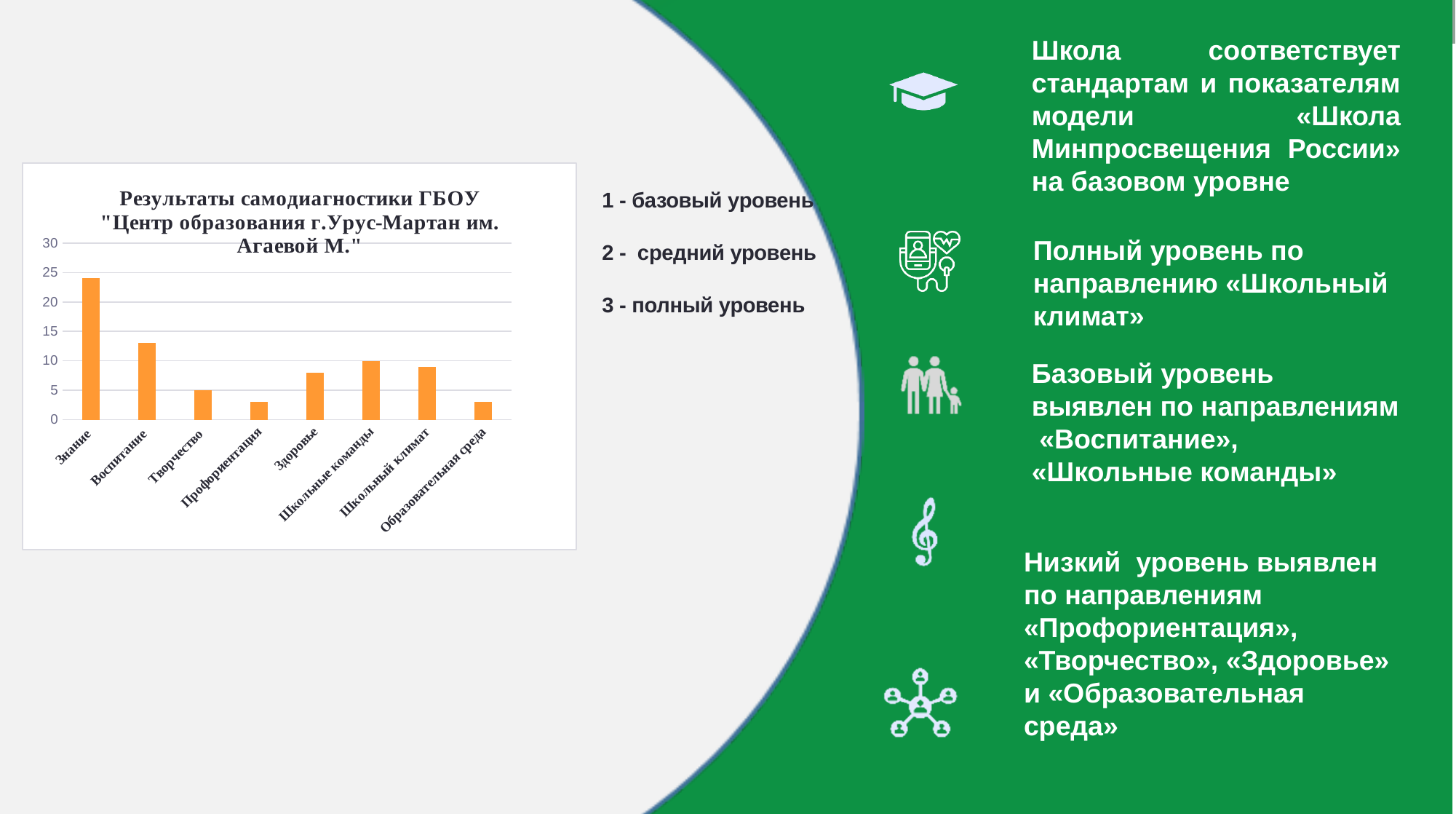
Is the value for Профориентация greater or less than 5? less What colour are the bars in the chart? orange What is the value for Школьные команды? 10 Which category has the highest bar in the chart? Знание Is the value for Здоровье greater or less than 10? less How many categories are shown on the x axis of the chart? 8 What kind of chart is shown on the slide? bar chart What is the value for Творчество? 5 Which is larger, the value for Знание or the value for Воспитание? Знание Is the value for Знание greater or less than 20? greater Which is larger, the value for Воспитание or the value for Школьные команды? Воспитание